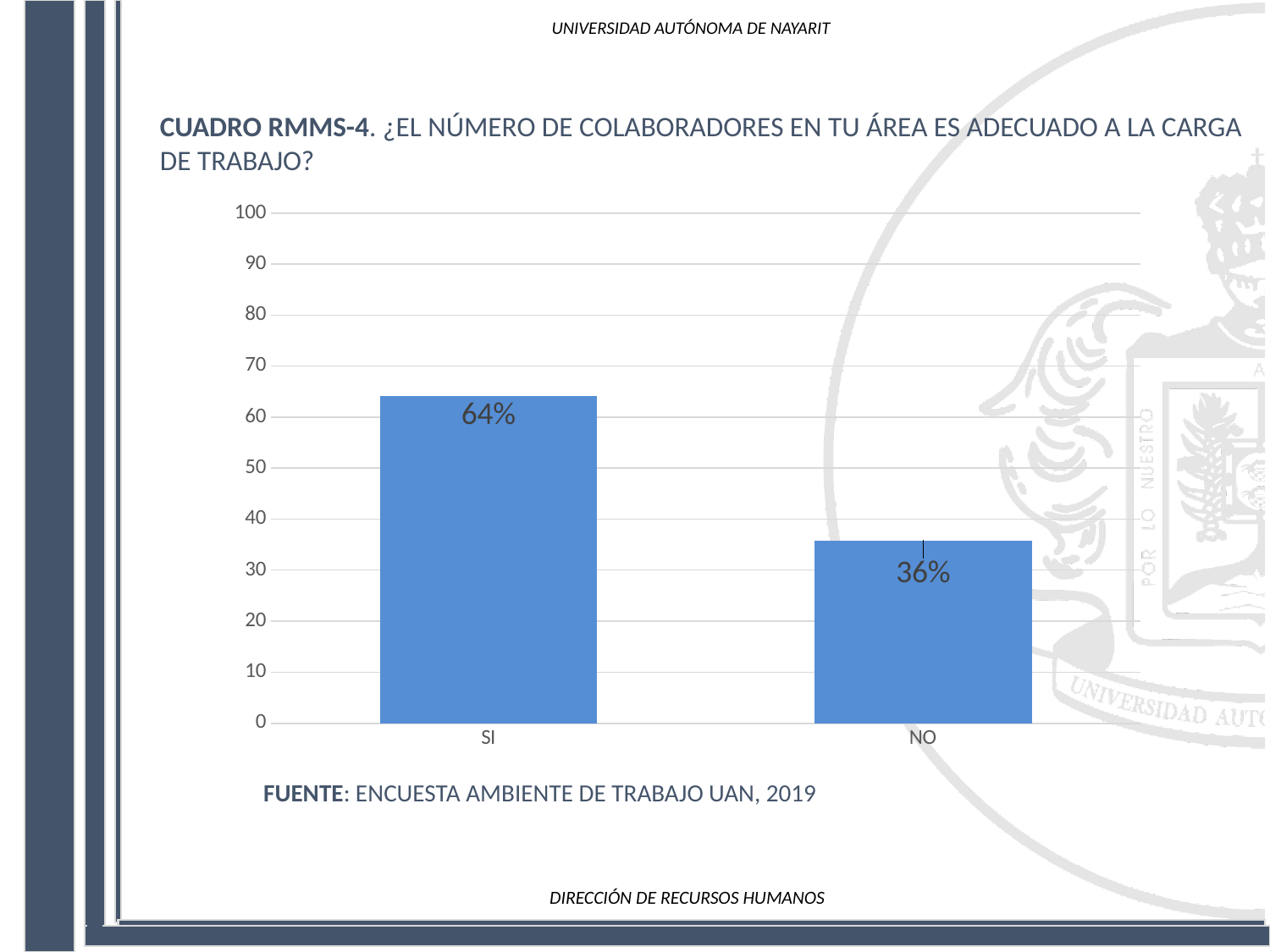
What is the value for NO? 36% What source is cited below the chart? ENCUESTA AMBIENTE DE TRABAJO UAN, 2019 What is the difference between the values for SI and NO? 28% Which category has the lowest value? NO Is the value for NO greater or less than 40? less How many categories are shown on the x axis? 2 Which category has the highest value? SI What kind of chart is shown on the slide? bar chart What is the value for SI? 64% Is the value for SI greater or less than 60? greater What is the maximum value shown on the y axis? 100 Which is larger, the value for SI or the value for NO? SI